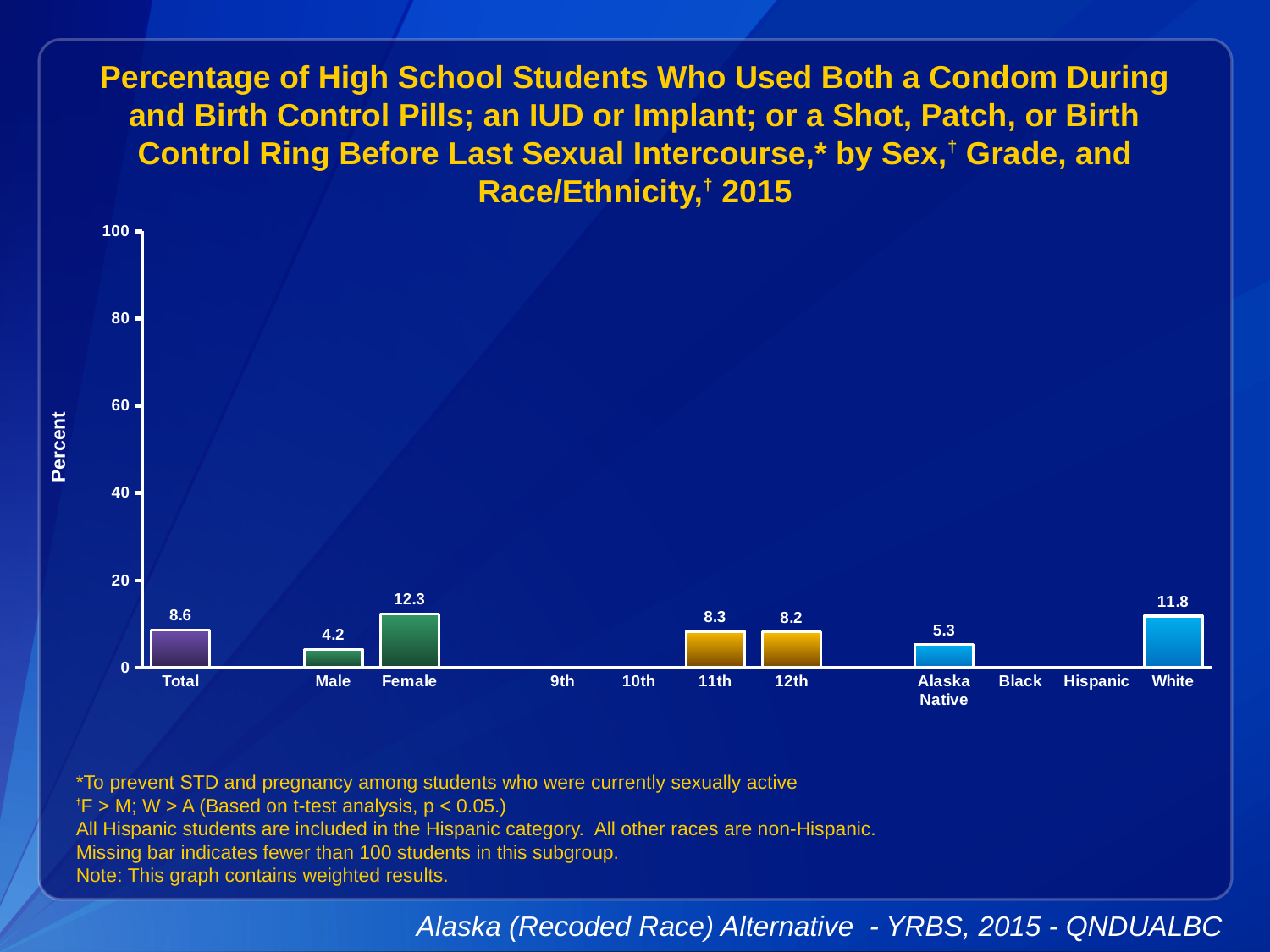
What is the difference between the 11th grade and 12th grade values? 0.1 Which category has the highest value? Female What is the value for Male? 4.2 What is the difference between the Female and Male values? 8.1 What is the value for Female? 12.3 What is the value for Total? 8.6 What is the label on the y axis? Percent Among the categories with a bar shown, which has the lowest value? Male What kind of chart is shown on the slide? bar chart Which is larger, the value for White or the value for Alaska Native? White Is the value for Female greater or less than 20? less What is the value for Alaska Native? 5.3